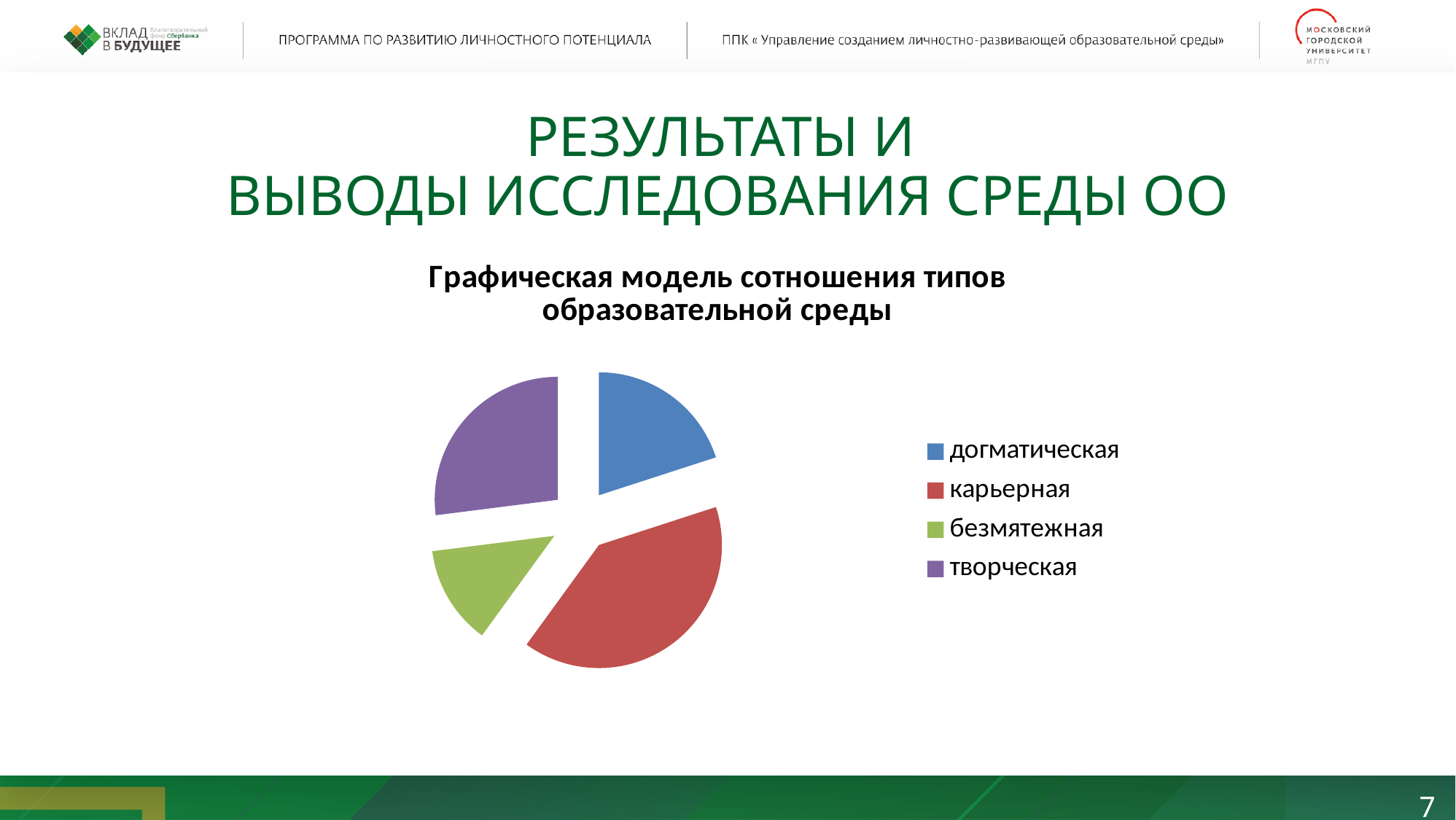
Which type of educational environment has the largest slice in the pie chart? карьерная Which slice is larger in the pie chart, карьерная or творческая? карьерная Which slice is larger in the pie chart, карьерная or безмятежная? карьерная Which slice is larger in the pie chart, творческая or догматическая? творческая What colour represents карьерная in the pie chart? red What kind of chart is shown on the slide? pie chart What is the title of the pie chart? Графическая модель сотношения типов образовательной среды How many entries does the legend of the pie chart list? 4 How many slices does the pie chart have? 4